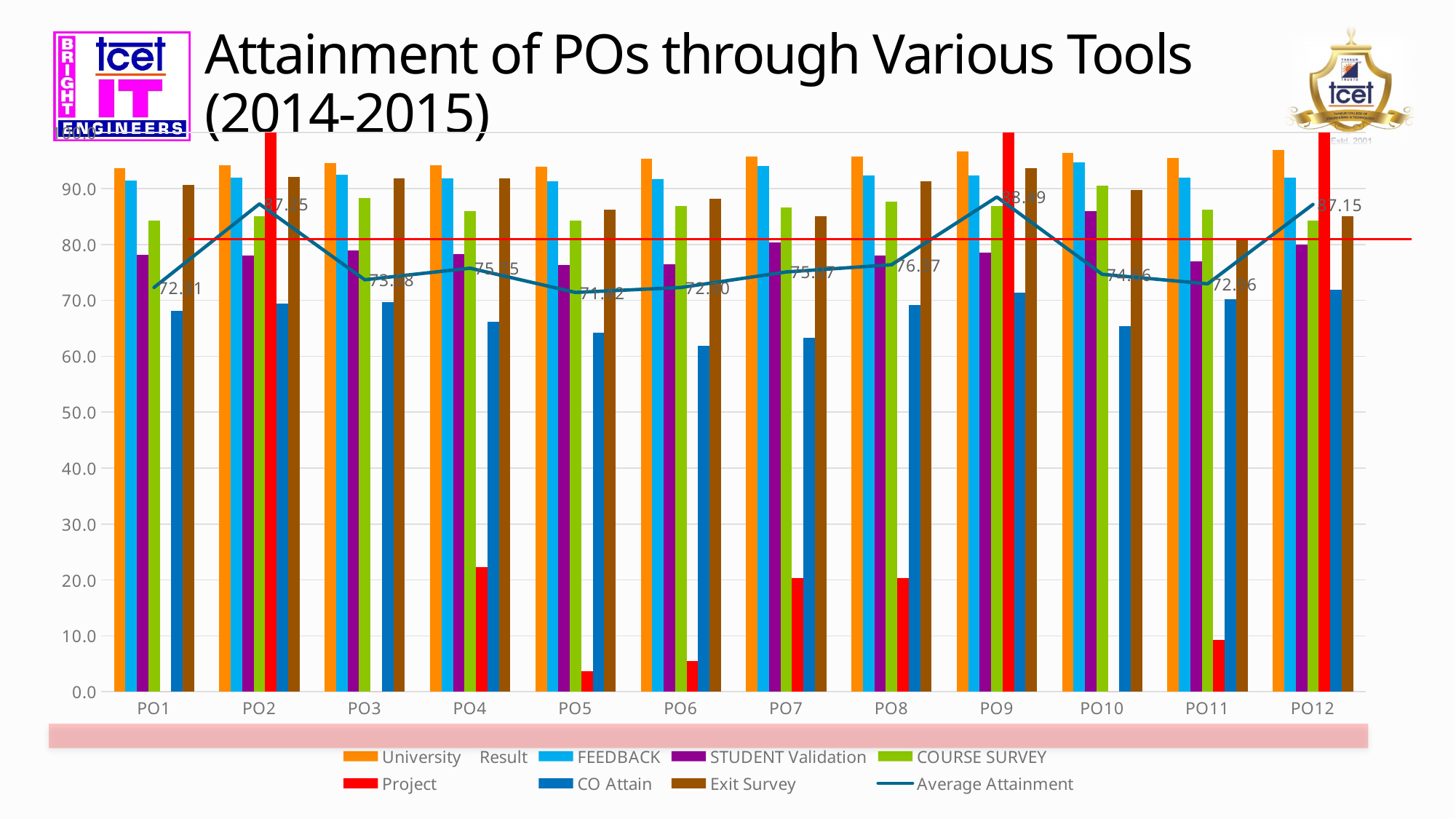
How many series does the legend list? 8 Is the CO Attain value for PO6 greater or less than 60.0? greater How many PO categories are shown on the x axis? 12 Which colour represents the Project series in the legend? Red Is the Project value for PO4 greater or less than 20.0? greater What is the difference between the Average Attainment values for PO12 and PO1? 14.84 Is the Project value for PO5 greater or less than 10.0? less What kind of chart is shown on the slide? Bar chart with a line series What is the Average Attainment value for PO12? 87.15 Which is larger, the Average Attainment for PO1 or for PO12? PO12 What is the Average Attainment value for PO1? 72.31 Which PO has the highest Average Attainment value? PO9